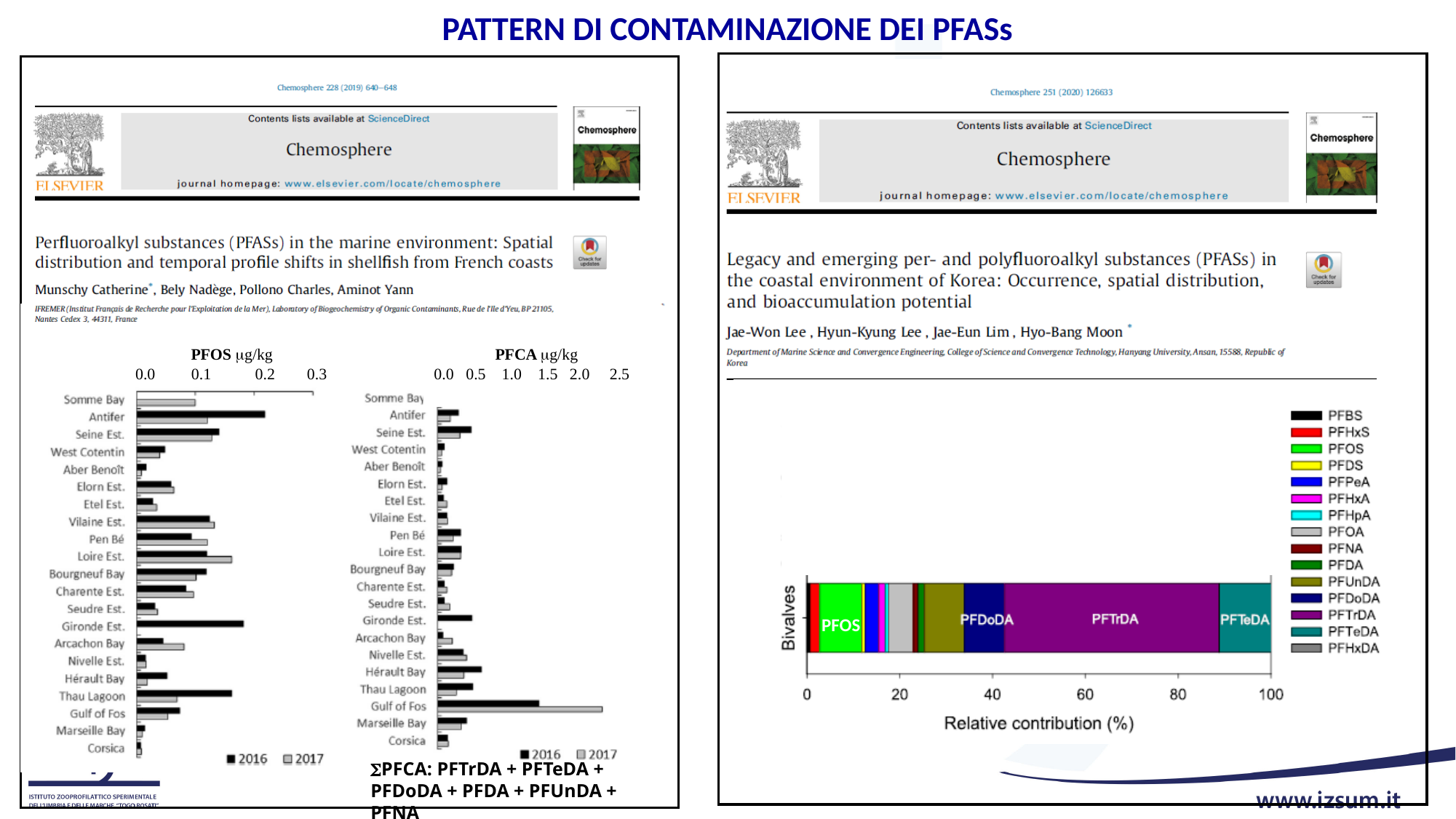
What kind of chart is the Relative contribution (%) chart on the right? stacked bar chart On the PFOS µg/kg chart, which site has the highest 2016 value? Antifer How many series does the legend of the PFOS µg/kg chart list? 2 On the PFCA µg/kg chart, is the 2017 value for Gulf of Fos greater or less than 2.0? greater What kind of chart is the PFOS µg/kg chart on the left? bar chart On the PFCA µg/kg chart, which site has the highest value? Gulf of Fos How many sites (categories) are shown on the PFOS µg/kg chart? 21 On the PFOS µg/kg chart, is the 2016 value for Gironde Est. greater or less than 0.1? greater On the PFCA µg/kg chart, is the 2016 value for Gulf of Fos greater or less than 1.0? greater On the PFOS µg/kg chart, which is larger for Antifer: the 2016 value or the 2017 value? 2016 How many compounds does the legend of the Relative contribution (%) chart on the right list? 15 On the Relative contribution (%) chart on the right, which compound has the largest segment in the Bivalves bar? PFTrDA